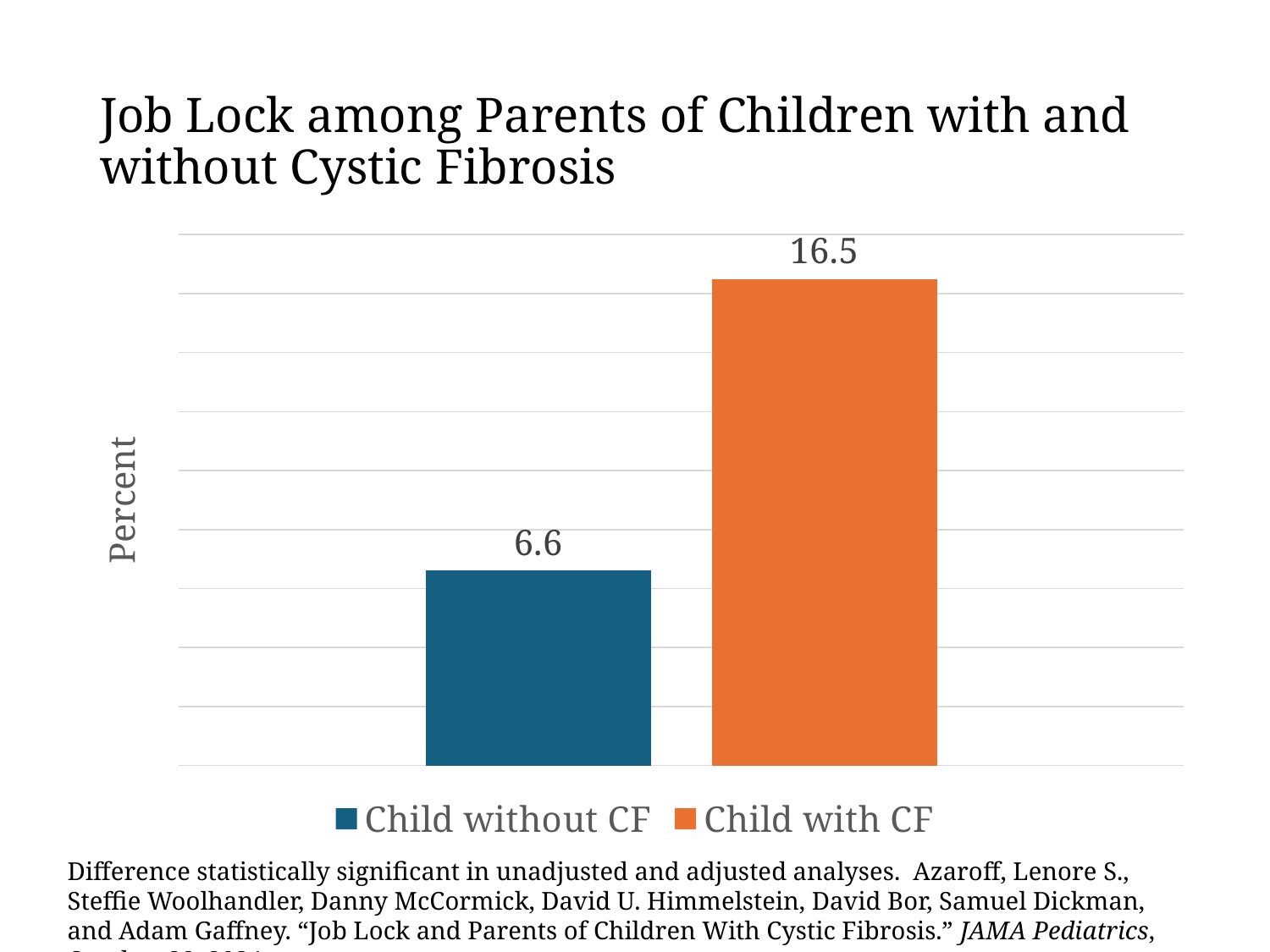
How many bars are plotted on the chart? 2 What is the value for Child with CF? 16.5 What is the value for Child without CF? 6.6 What is the difference between the values for Child with CF and Child without CF? 9.9 How many series does the legend list? 2 Is the value for Child with CF larger or smaller than the value for Child without CF? larger What is the title of the chart? Job Lock among Parents of Children with and without Cystic Fibrosis What kind of chart is shown on the slide? bar chart Which series has the lower value? Child without CF Which series has the higher value? Child with CF What is the label on the vertical axis? Percent